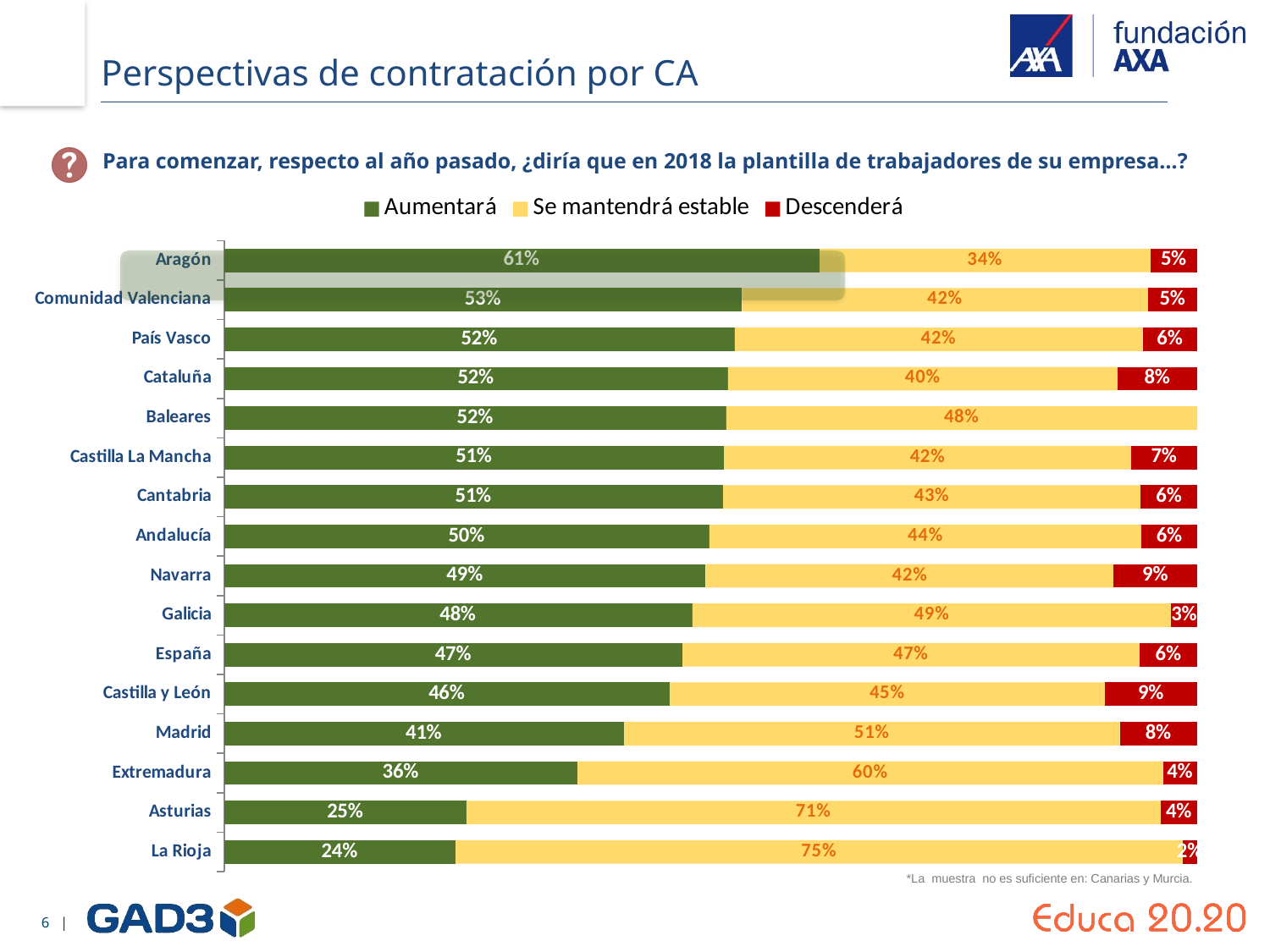
Which region has the highest value for "Se mantendrá estable"? La Rioja What is the difference between the "Aumentará" values for Aragón and Madrid? 20% How many series does the legend list? 3 How many regions (categories) are shown in the chart? 16 Which region has the lowest value for "Aumentará"? La Rioja Which series is shown in red in the chart? Descenderá Which region has the highest value for "Aumentará"? Aragón What kind of chart is shown on the slide? Stacked bar chart What is the value of "Aumentará" for Aragón? 61% Which is larger: the "Descenderá" value for Cataluña or for Galicia? Cataluña What is the value of "Descenderá" for Navarra? 9% What is the value of "Se mantendrá estable" for La Rioja? 75%